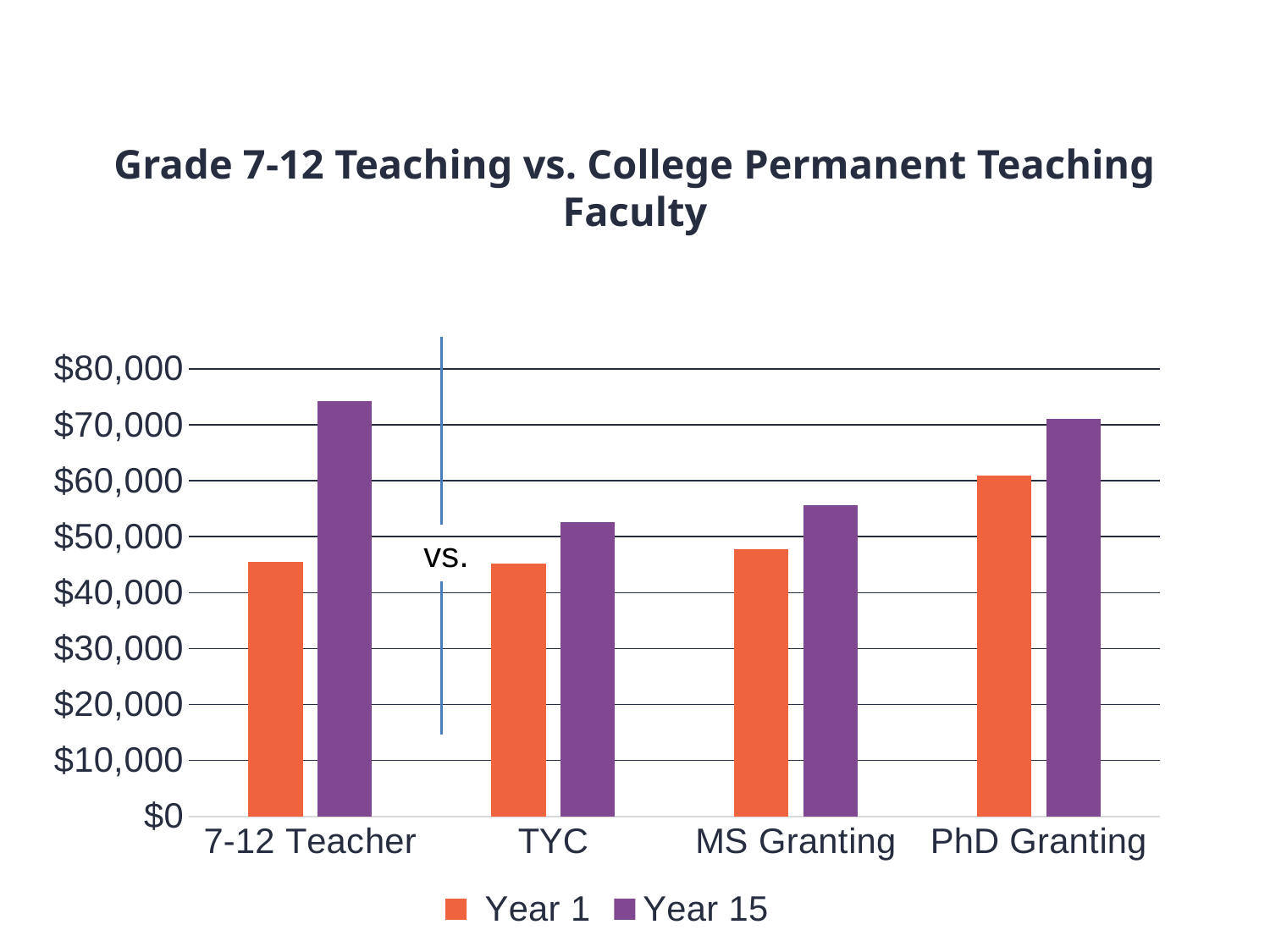
Is the Year 15 value for TYC greater or less than $50,000? greater How many series does the legend list? 2 What kind of chart is shown on the slide? bar chart Which category has the highest Year 15 value? 7-12 Teacher How many categories are shown on the x axis? 4 Which category has the lowest Year 15 value? TYC Which category has the highest Year 1 value? PhD Granting Which is larger, the Year 1 value for PhD Granting or the Year 1 value for TYC? PhD Granting Is the Year 1 value for PhD Granting greater or less than $50,000? greater Is the Year 1 value for MS Granting greater or less than $50,000? less What is the title of the chart? Grade 7-12 Teaching vs. College Permanent Teaching Faculty